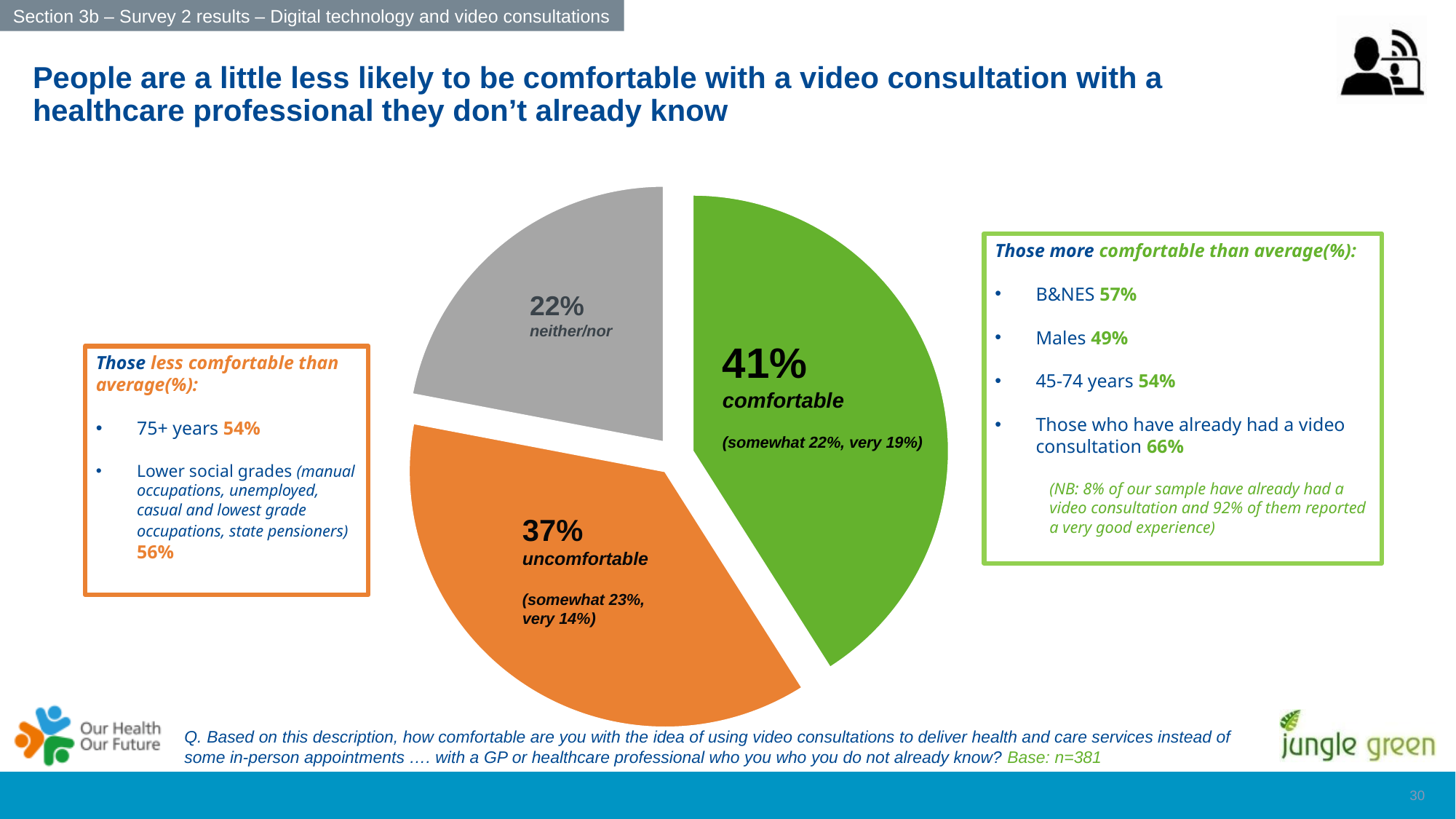
Which response category has the smallest share of the pie? neither/nor How many slices does the pie chart have? 3 What percentage of respondents are uncomfortable? 37% What percentage of respondents are very comfortable? 19% What percentage of respondents are somewhat uncomfortable? 23% What colour is the uncomfortable slice of the pie chart? orange What kind of chart is shown on the slide? pie chart Which response category has the largest share of the pie? comfortable What percentage of respondents answered neither/nor? 22% Which is larger, the uncomfortable slice or the neither/nor slice? uncomfortable What percentage of respondents are comfortable with a video consultation with a healthcare professional they do not already know? 41% What is the difference in percentage points between the comfortable and uncomfortable slices? 4